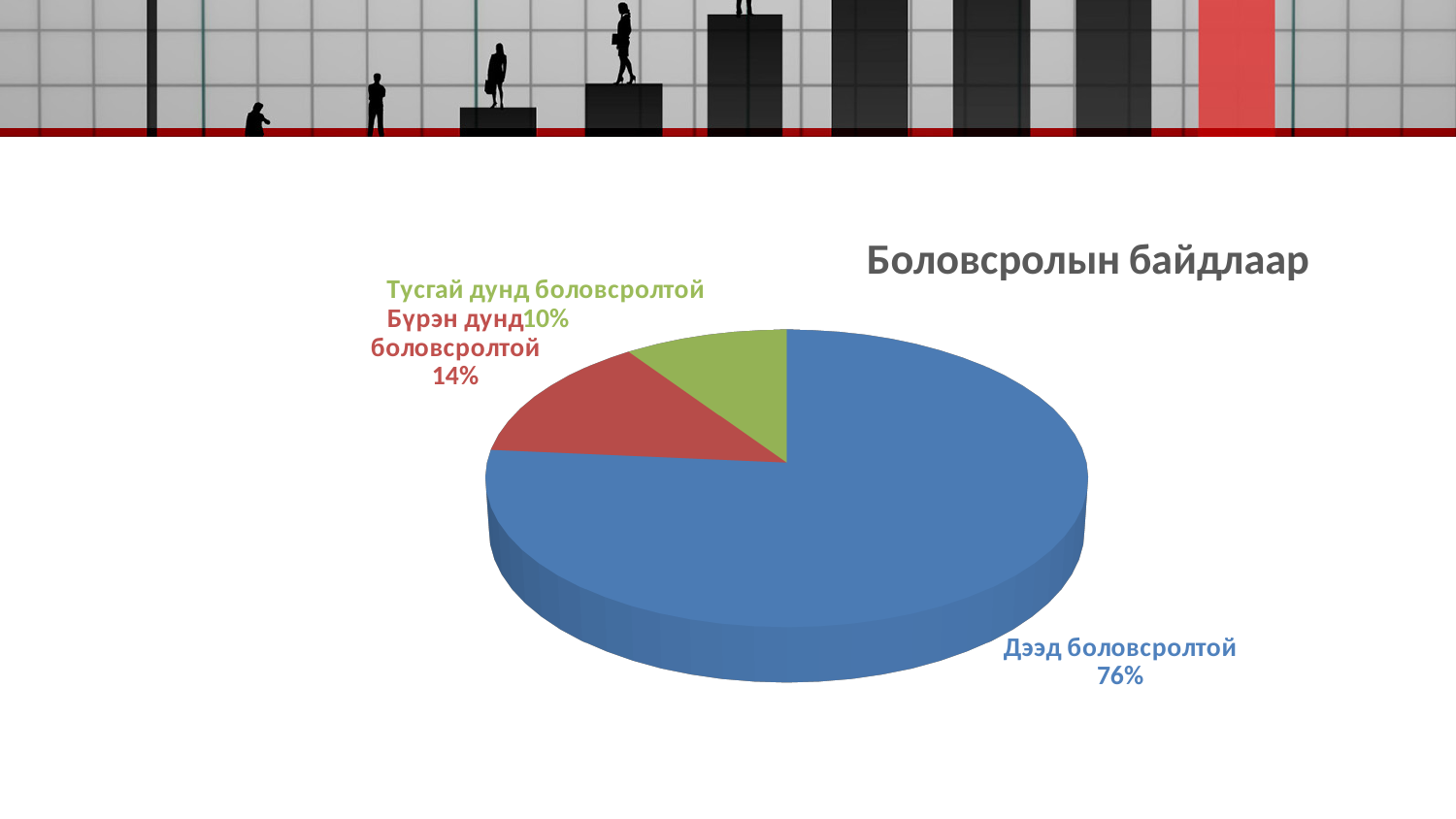
Which category has the smallest slice of the pie? Тусгай дунд боловсролтой What is the difference in percentage points between Дээд боловсролтой and Бүрэн дунд боловсролтой? 62 How many slices does the pie chart have? 3 Which category has the largest slice of the pie? Дээд боловсролтой What share of the pie does Тусгай дунд боловсролтой have? 10% Which is larger, the share for Бүрэн дунд боловсролтой or the share for Тусгай дунд боловсролтой? Бүрэн дунд боловсролтой What share of the pie does Дээд боловсролтой have? 76% What colour is the slice for Дээд боловсролтой? Blue What is the difference in percentage points between Бүрэн дунд боловсролтой and Тусгай дунд боловсролтой? 4 What share of the pie does Бүрэн дунд боловсролтой have? 14% What kind of chart is shown on the slide? Pie chart What is the title of the chart? Боловсролын байдлаар